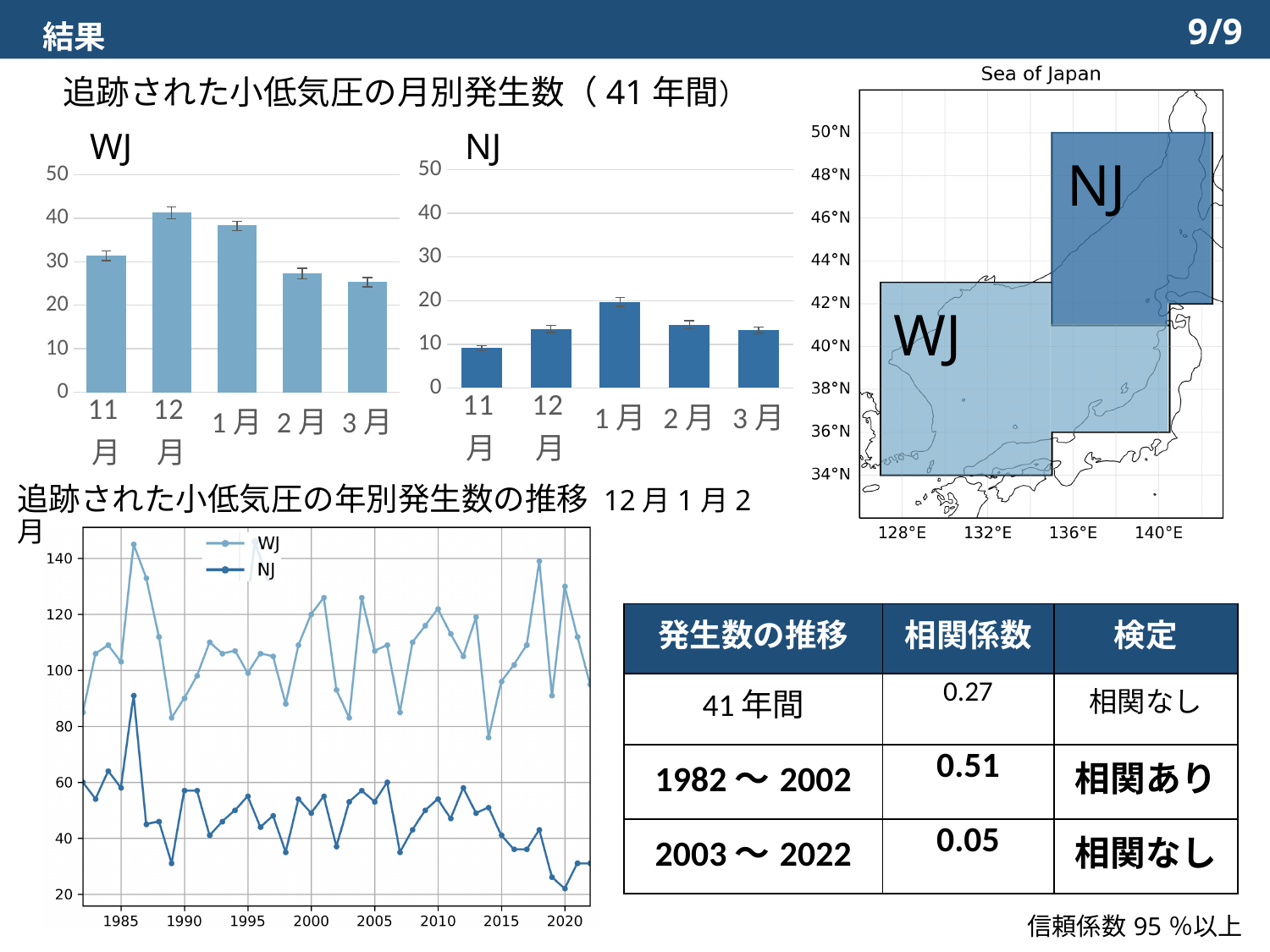
In the WJ bar chart (top left), is the value for 1月 greater or less than 30? greater What kind of chart is the WJ chart at the top left of the slide? bar chart In the NJ bar chart (top middle), which month has the highest value? 1月 In the NJ bar chart (top middle), which month has the lowest value? 11月 In the NJ bar chart (top middle), is the value for 1月 greater or less than 10? greater In the WJ bar chart (top left), which month has the highest value? 12月 In the WJ bar chart (top left), is the value for 2月 greater or less than 30? less How many series does the legend of the line chart at the bottom left list? 2 How many months (categories) are shown in the WJ bar chart (top left)? 5 In the line chart at the bottom left, which series has the higher values throughout the period, WJ or NJ? WJ In the WJ bar chart (top left), which is larger, the value for 12月 or the value for 1月? 12月